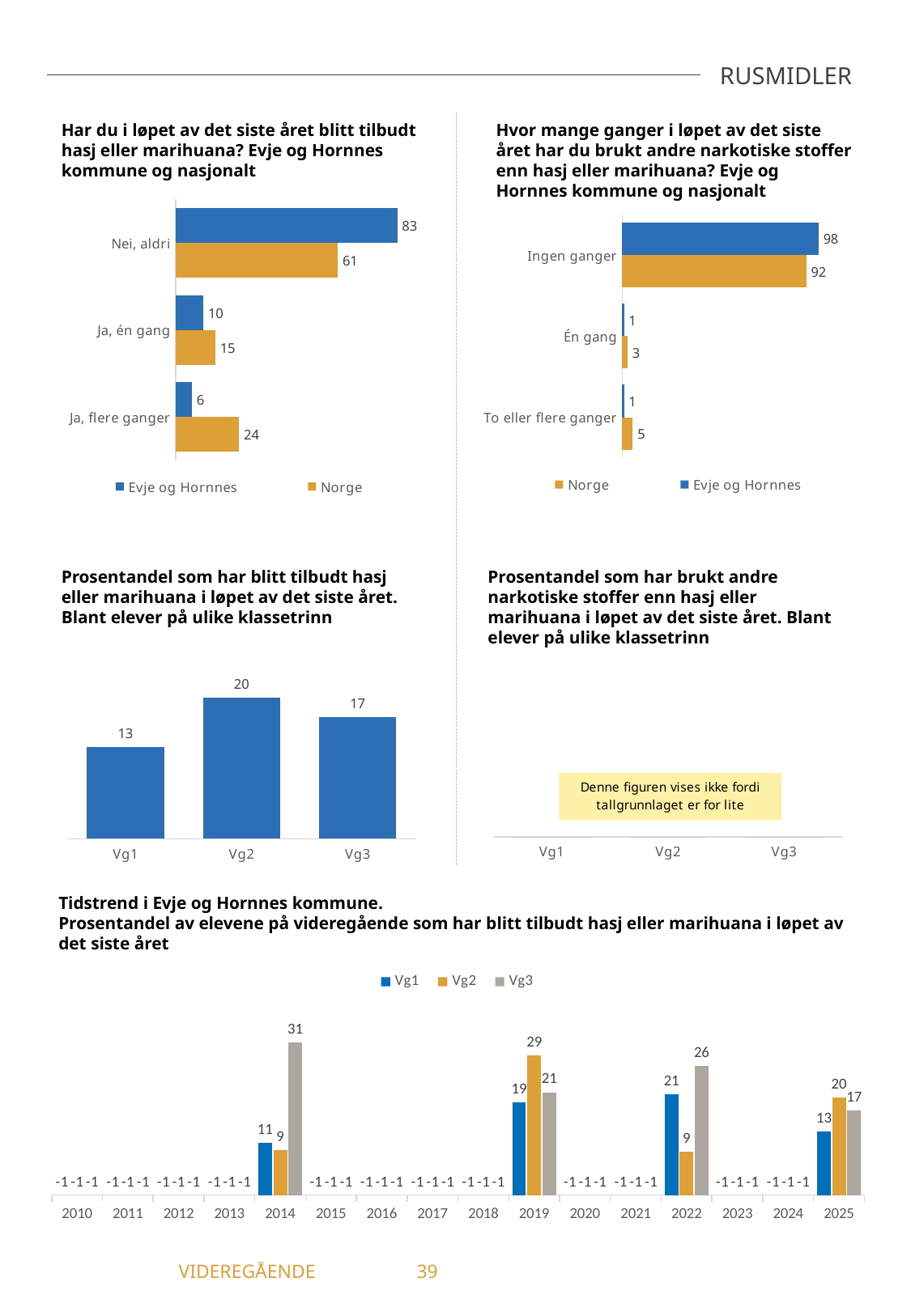
In the chart 'Har du i løpet av det siste året blitt tilbudt hasj eller marihuana?', what is the difference between the Evje og Hornnes and Norge values for 'Nei, aldri'? 22 In the chart 'Hvor mange ganger i løpet av det siste året har du brukt andre narkotiske stoffer enn hasj eller marihuana?', what is the value for Norge in the category 'Ingen ganger'? 92 In the chart 'Tidstrend i Evje og Hornnes kommune', what is the value for Vg3 in 2014? 31 What kind of chart is 'Prosentandel som har blitt tilbudt hasj eller marihuana i løpet av det siste året. Blant elever på ulike klassetrinn'? Bar chart In the chart 'Prosentandel som har blitt tilbudt hasj eller marihuana i løpet av det siste året. Blant elever på ulike klassetrinn', what is the value for Vg1? 13 In the chart 'Tidstrend i Evje og Hornnes kommune', what is the difference between the Vg2 values in 2019 and 2022? 20 In the chart 'Hvor mange ganger i løpet av det siste året har du brukt andre narkotiske stoffer enn hasj eller marihuana?', which is larger for 'To eller flere ganger': Norge or Evje og Hornnes? Norge In the chart 'Har du i løpet av det siste året blitt tilbudt hasj eller marihuana?', what is the value for Evje og Hornnes in the category 'Nei, aldri'? 83 In the chart 'Hvor mange ganger i løpet av det siste året har du brukt andre narkotiske stoffer enn hasj eller marihuana?', how many categories are shown? 3 In the chart 'Tidstrend i Evje og Hornnes kommune', how many series does the legend list? 3 In the chart 'Prosentandel som har blitt tilbudt hasj eller marihuana i løpet av det siste året. Blant elever på ulike klassetrinn', which class level has the highest value? Vg2 In the chart 'Har du i løpet av det siste året blitt tilbudt hasj eller marihuana?', what is the value for Norge in the category 'Ja, flere ganger'? 24